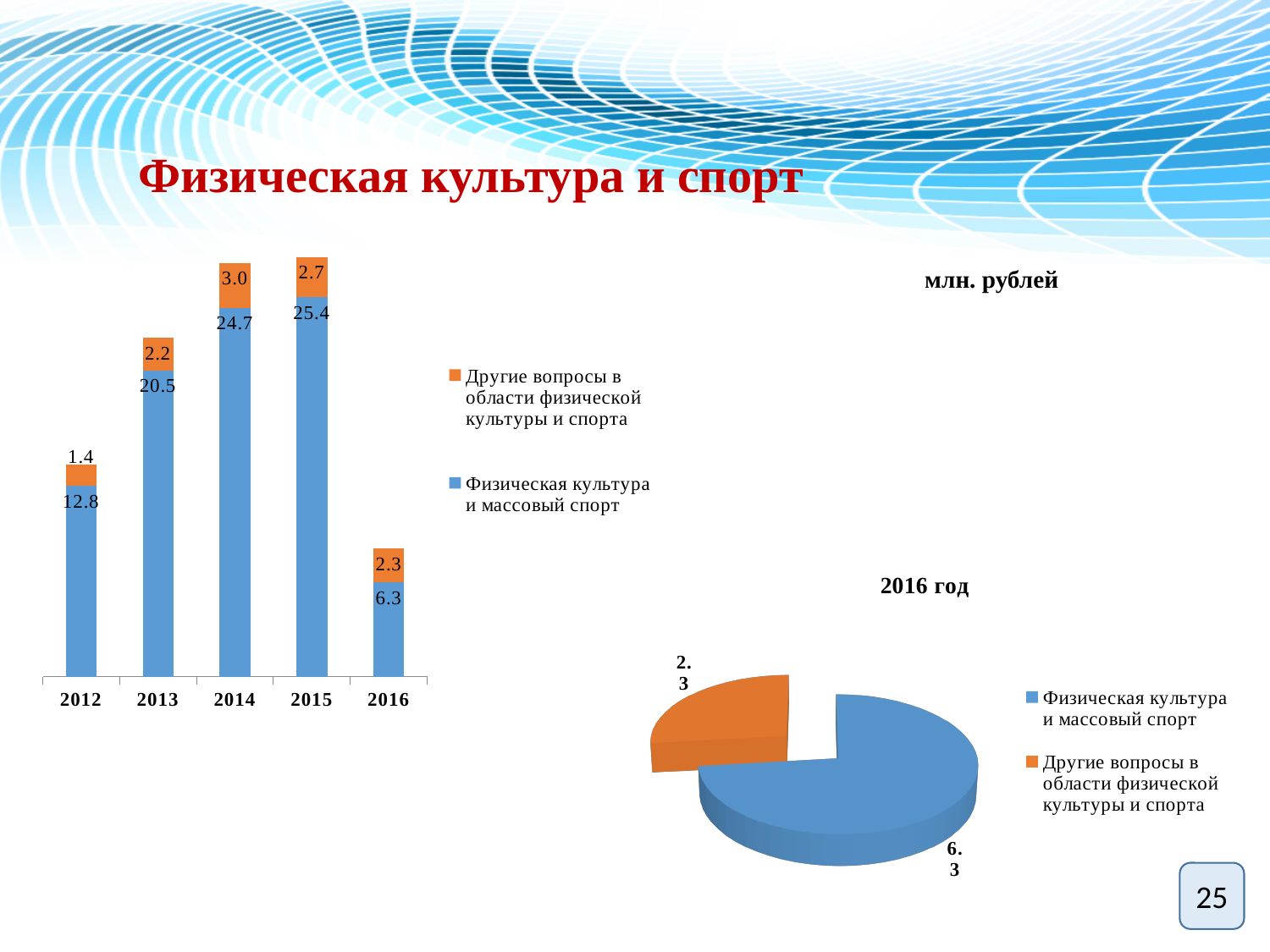
How many years are shown on the x axis of the bar chart on the left? 5 How many series does the legend of the bar chart on the left list? 2 What kind of chart is the chart on the left of the slide? Stacked bar chart In the pie chart titled 2016 год, which slice is larger? Физическая культура и массовый спорт In the bar chart on the left, what is the value for Физическая культура и массовый спорт in 2015? 25.4 In the bar chart on the left, what is the total of the stacked bar for 2012? 14.2 In the pie chart titled 2016 год, what is the value for Другие вопросы в области физической культуры и спорта? 2.3 In the bar chart on the left, which year has the highest value for Физическая культура и массовый спорт? 2015 In the bar chart on the left, what is the value for Другие вопросы в области физической культуры и спорта in 2014? 3.0 In the bar chart on the left, which year has the lowest value for Физическая культура и массовый спорт? 2016 In the bar chart on the left, what is the difference between the 2015 and 2014 values for Физическая культура и массовый спорт? 0.7 In the bar chart on the left, which is larger: the value for Другие вопросы в области физической культуры и спорта in 2013 or in 2012? 2013